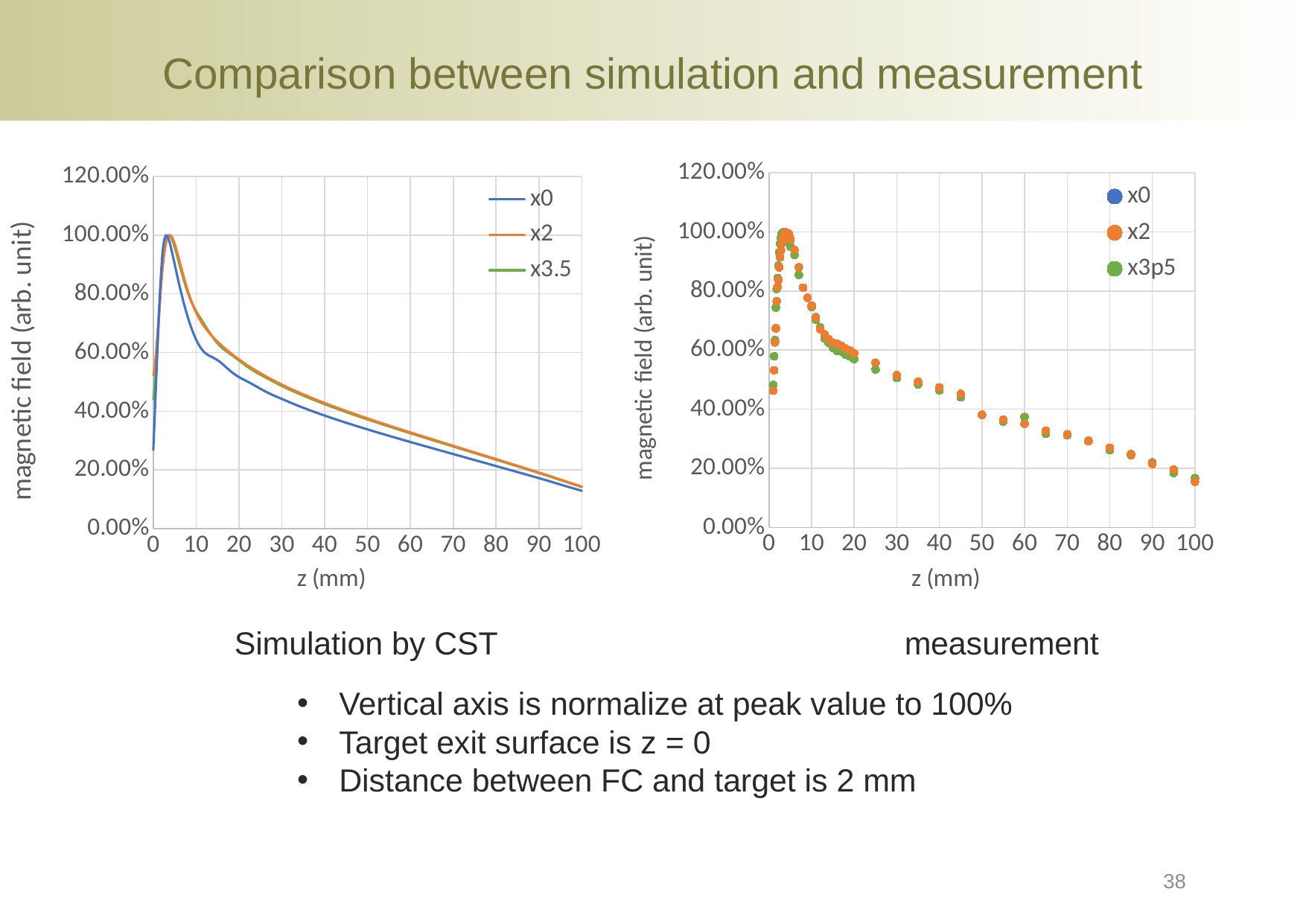
What kind of chart is the 'Simulation by CST' chart on the left? line chart In the 'Simulation by CST' chart, is the value of x0 at z = 100 greater or less than 20.00%? less In the 'Simulation by CST' chart, at z = 20, which series has the larger value, x0 or x2? x2 How many series does the legend of the 'Simulation by CST' chart list? 3 In the 'Simulation by CST' chart, what is the label of the vertical axis? magnetic field (arb. unit) In the 'Simulation by CST' chart, is the value of x2 at z = 30 greater or less than 40.00%? greater What kind of chart is the 'measurement' chart on the right? scatter chart In the 'measurement' chart, do the values rise or fall along the x axis from z = 20 to z = 100? fall In the 'measurement' chart, what are the legend entries? x0, x2, x3p5 In the 'Simulation by CST' chart, do the values rise or fall along the x axis after the peak near z = 5 mm? fall In the 'measurement' chart, is the value at z = 100 greater or less than 20.00%? less How many series does the legend of the 'measurement' chart list? 3